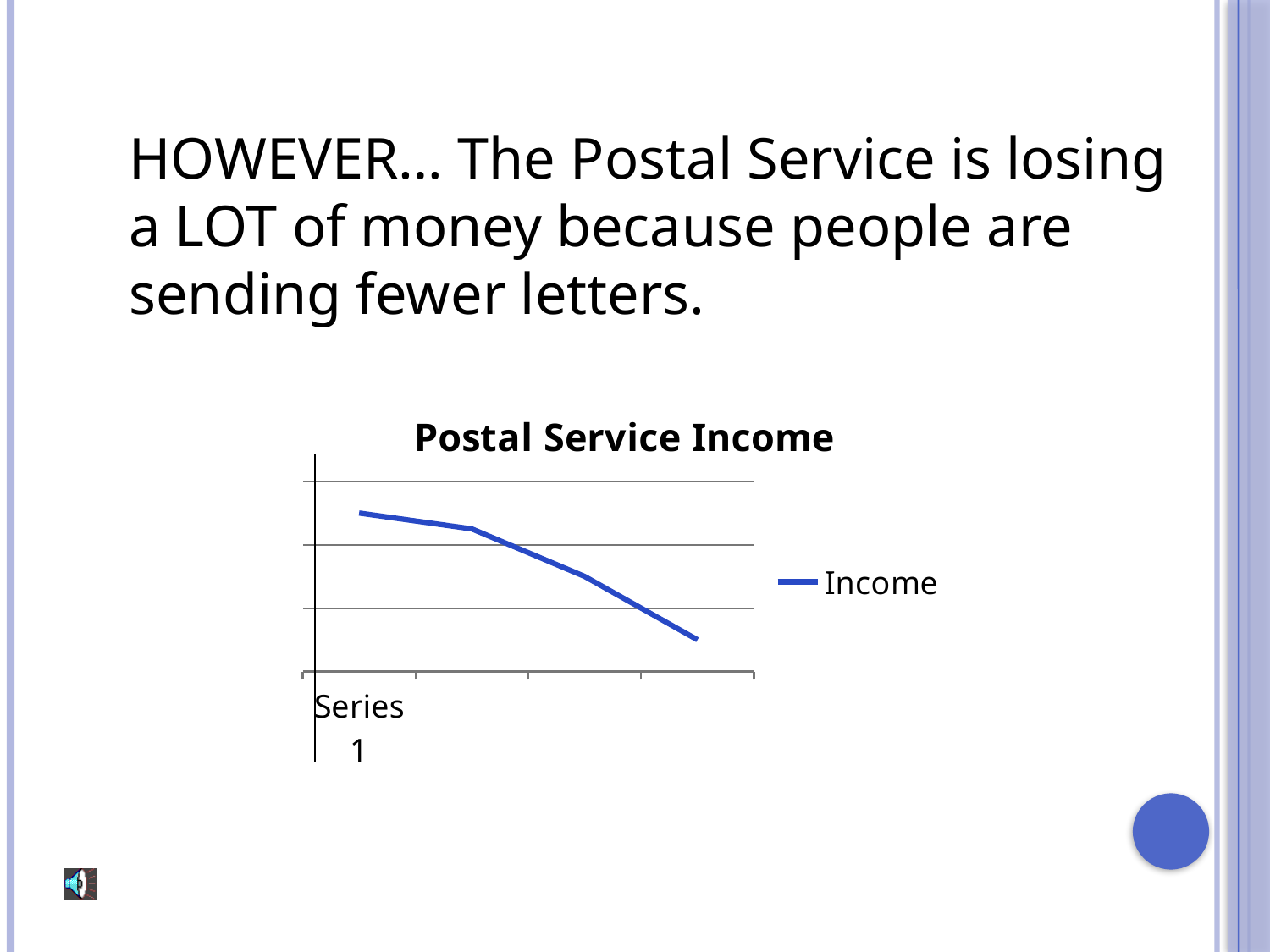
What is the title of the chart? Postal Service Income What is the name of the series shown in the legend? Income How many data points are plotted on the Income line? 4 How many series does the legend list? 1 Do the Income values rise or fall from left to right along the x axis? fall What kind of chart is shown on the slide? line chart Is the first point on the Income line higher or lower than the last point? higher